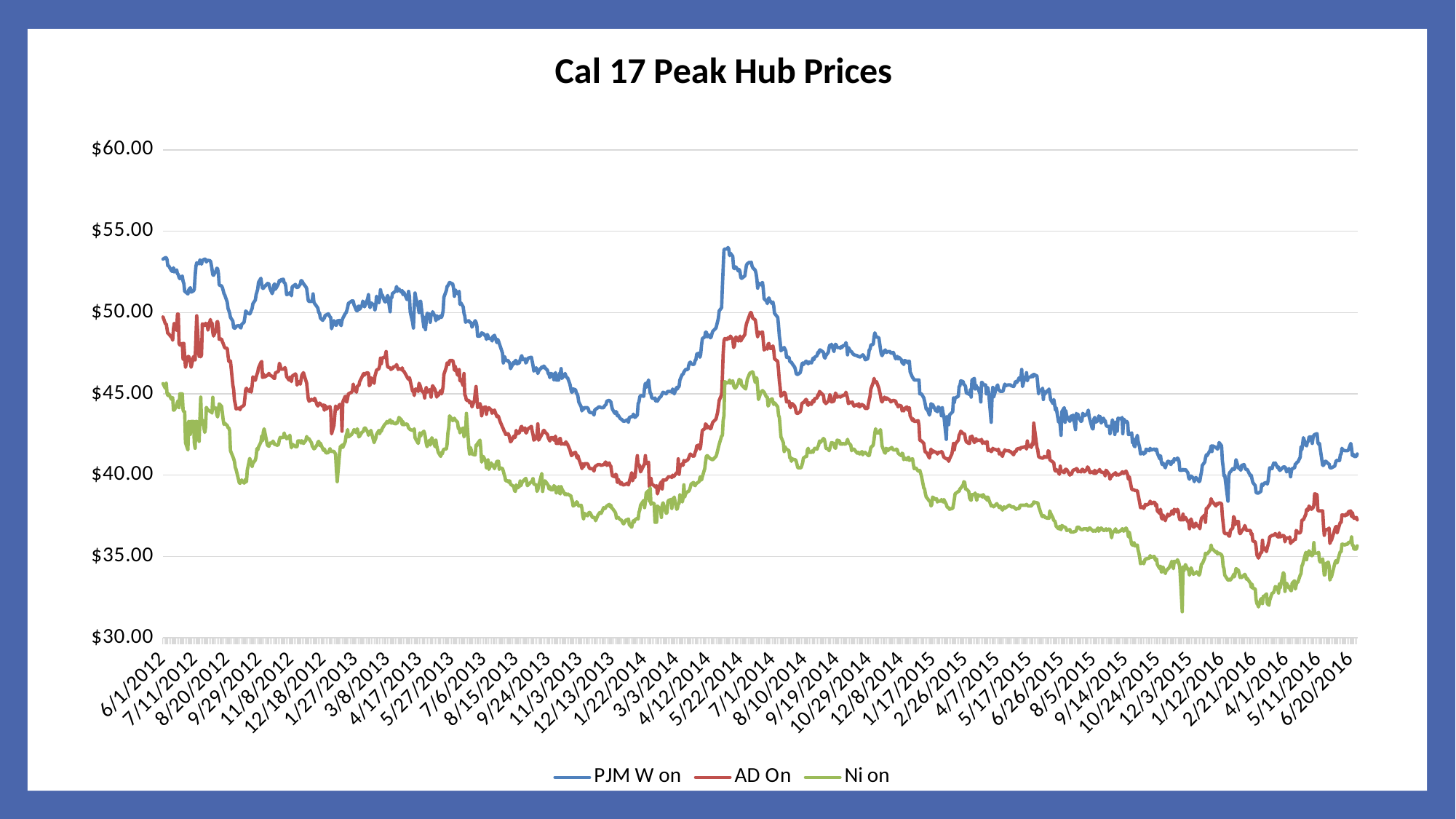
What kind of chart is shown on the slide? line chart Do the prices generally rise or fall from 6/1/2012 to 6/20/2016? fall Which series is plotted with the green line? Ni on Which series has the highest prices across the whole period? PJM W on Is the value for PJM W on at 6/1/2012 greater or less than $50.00? greater Is the highest value reached by PJM W on around 5/22/2014 greater or less than $55.00? less What is the title of the chart? Cal 17 Peak Hub Prices Is the value for AD On at 6/20/2016 greater or less than $35.00? greater How many series does the legend list? 3 Which series has the lowest prices across the whole period? Ni on At 6/20/2016, which is larger, the value for PJM W on or the value for Ni on? PJM W on